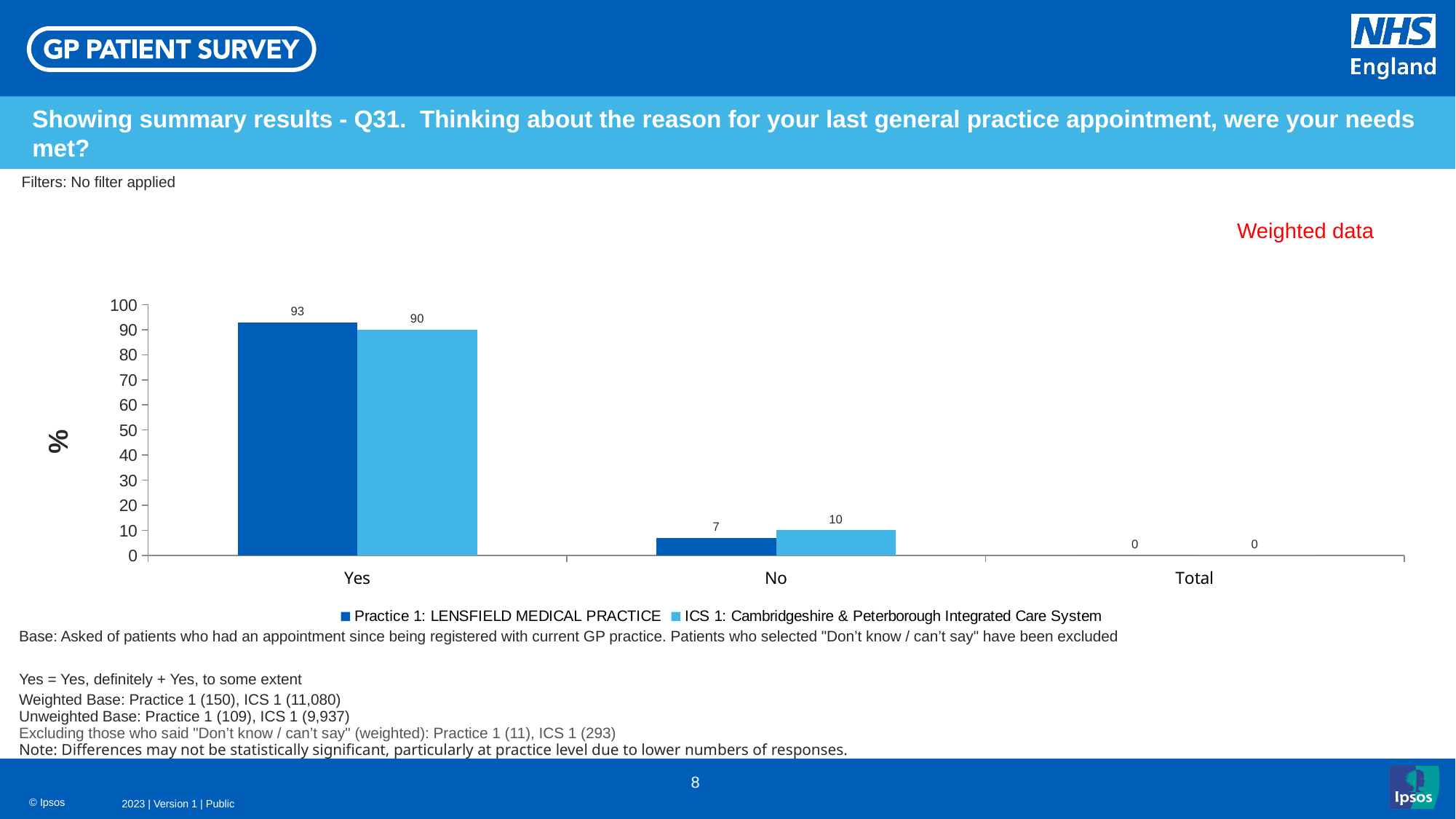
What is the label on the y axis? % What kind of chart is shown on the slide? Bar chart What is the difference between the ICS 1 and Practice 1 values in the No category? 3 How many series does the legend list? 2 What is the value for ICS 1: Cambridgeshire & Peterborough Integrated Care System in the Yes category? 90 What is the value for Practice 1: LENSFIELD MEDICAL PRACTICE in the Yes category? 93 In the No category, which is larger: Practice 1: LENSFIELD MEDICAL PRACTICE or ICS 1: Cambridgeshire & Peterborough Integrated Care System? ICS 1: Cambridgeshire & Peterborough Integrated Care System How many categories are shown on the x axis? 3 What is the difference between the Practice 1 and ICS 1 values in the Yes category? 3 Which category has the highest value for Practice 1: LENSFIELD MEDICAL PRACTICE? Yes What is the value for ICS 1: Cambridgeshire & Peterborough Integrated Care System in the No category? 10 What is the value for Practice 1: LENSFIELD MEDICAL PRACTICE in the No category? 7